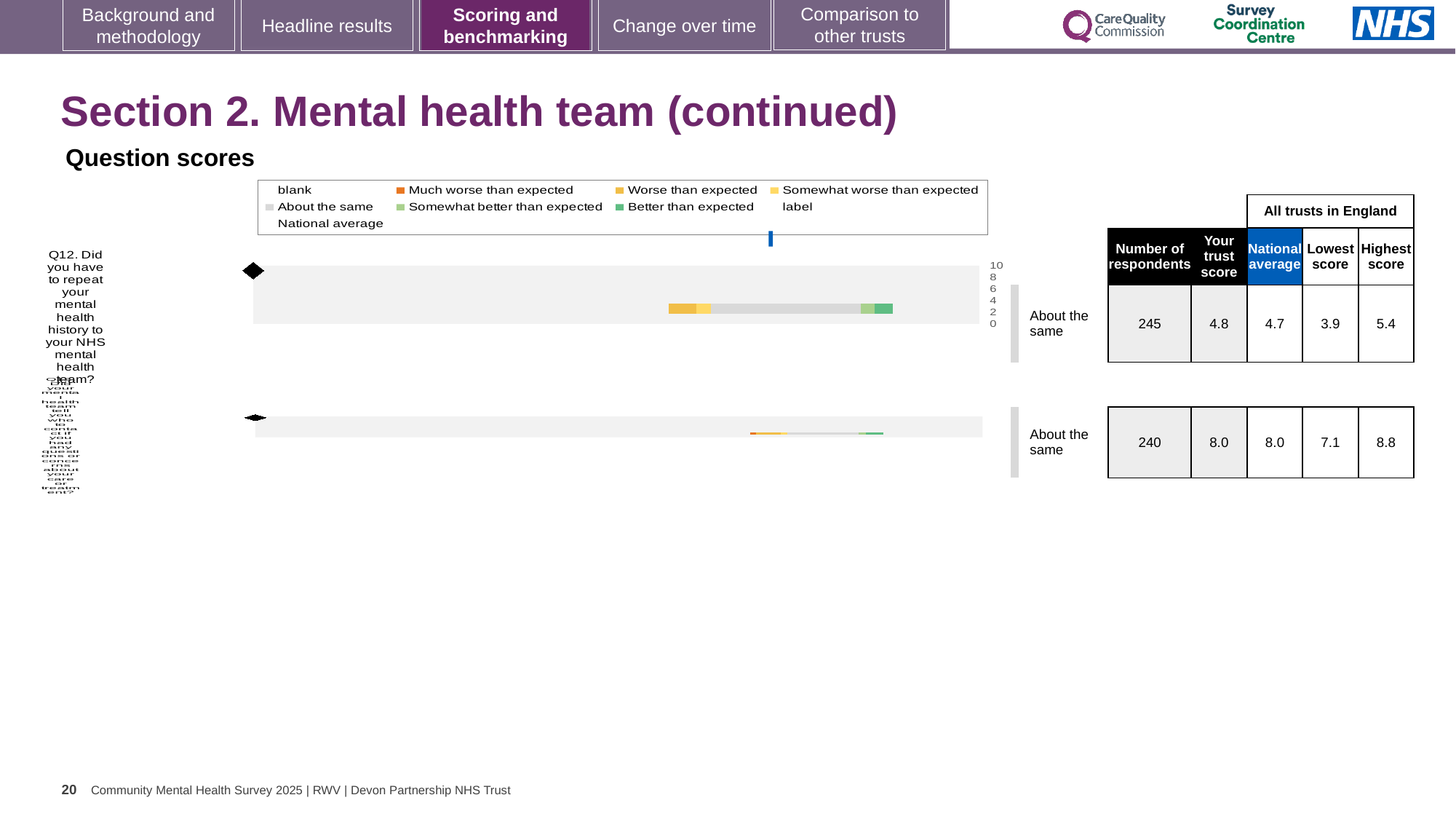
For the Q12 chart, what is the number of respondents shown in the table? 245 For the Q12 chart, what is the difference between the highest score and the lowest score across all trusts in England? 1.5 For the lower chart, what benchmark category is shown to the right of the bar? About the same For the Q12 chart, what is the national average? 4.7 For the lower chart, what is the difference between the highest score and the lowest score across all trusts in England? 1.7 For the lower chart, what is the number of respondents? 240 What kind of chart is used to show the question scores on this slide? bar chart For the Q12 chart (repeating mental health history), what benchmark category is shown to the right of the bar? About the same How many question score charts are shown on the slide? 2 For the lower chart, what is the highest score across all trusts in England? 8.8 For the Q12 chart, what is your trust score? 4.8 For the Q12 chart, which is larger: your trust score or the national average? Your trust score